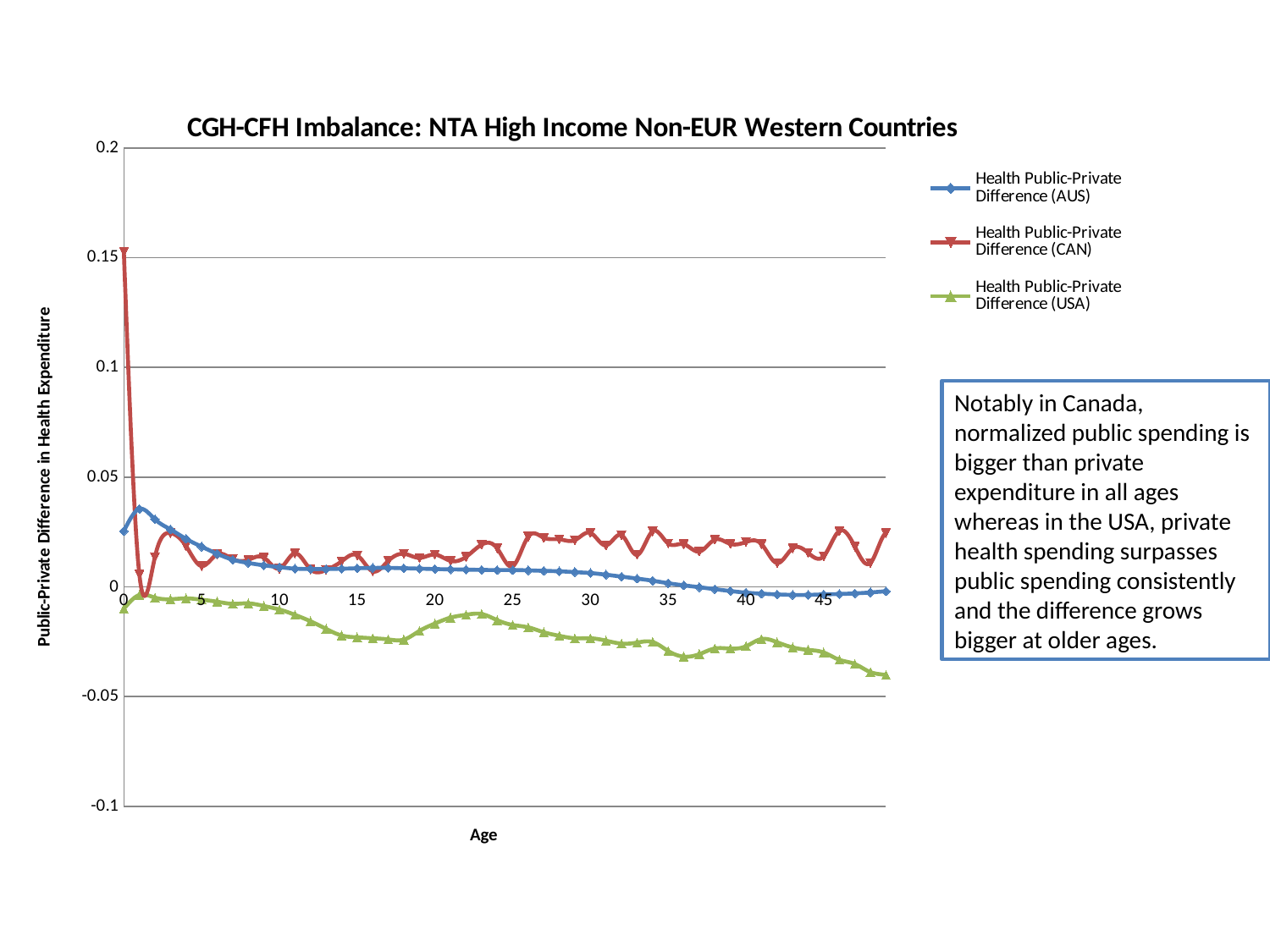
Does the Health Public-Private Difference (AUS) series rise or fall from age 5 to age 45? fall How many series does the legend list? 3 What is the label of the x axis? Age Which series has the highest value at age 0? Health Public-Private Difference (CAN) What is the title of the chart? CGH-CFH Imbalance: NTA High Income Non-EUR Western Countries At age 45, which is larger: the value for Health Public-Private Difference (CAN) or Health Public-Private Difference (USA)? Health Public-Private Difference (CAN) Which series has the lowest value at age 45? Health Public-Private Difference (USA) What kind of chart is shown on the slide? line chart Is the value for Health Public-Private Difference (CAN) at age 0 greater or less than 0.1? greater Is the value for Health Public-Private Difference (USA) at age 45 greater or less than 0? less Does the Health Public-Private Difference (USA) series generally rise or fall as age increases? fall Is the value for Health Public-Private Difference (CAN) at age 30 greater or less than 0.05? less